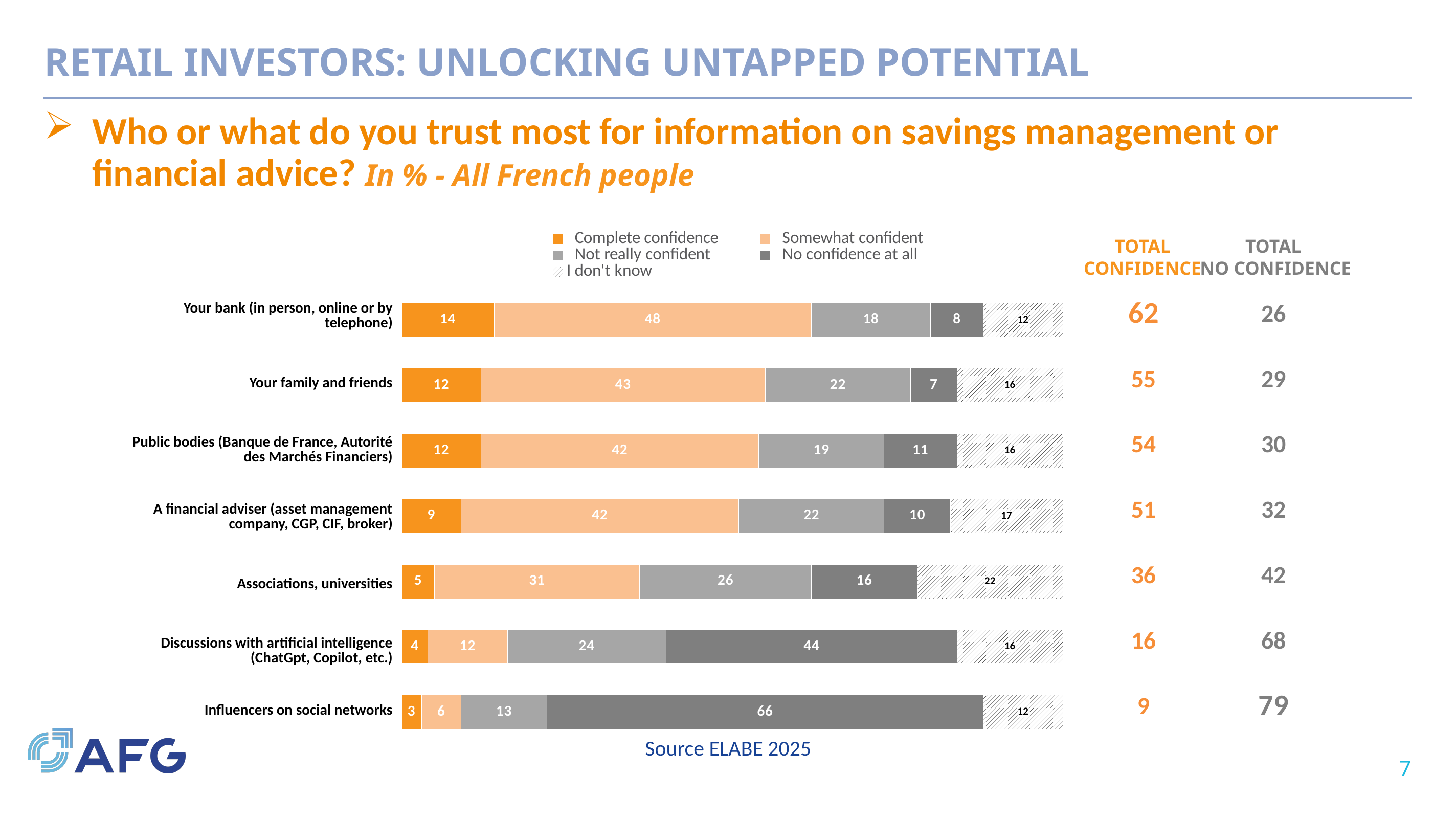
What kind of chart is shown on the slide? Stacked bar chart What is the difference between the 'No confidence at all' values for 'Influencers on social networks' and 'Discussions with artificial intelligence (ChatGpt, Copilot, etc.)'? 22 Which category has the lowest 'No confidence at all' value? Your family and friends What is the TOTAL CONFIDENCE figure shown for 'Public bodies (Banque de France, Autorité des Marchés Financiers)'? 54 What is the 'No confidence at all' value for 'Influencers on social networks'? 66 What is the 'Complete confidence' value for 'A financial adviser (asset management company, CGP, CIF, broker)'? 9 Which is larger: the 'Not really confident' value for 'Your family and friends' or for 'Public bodies (Banque de France, Autorité des Marchés Financiers)'? Your family and friends What is the 'Somewhat confident' value for 'Your bank (in person, online or by telephone)'? 48 How many categories (sources of information) are plotted in the chart? 7 What is the 'I don't know' value for 'Associations, universities'? 22 Which category has the highest 'Complete confidence' value? Your bank (in person, online or by telephone) How many series does the legend list? 5